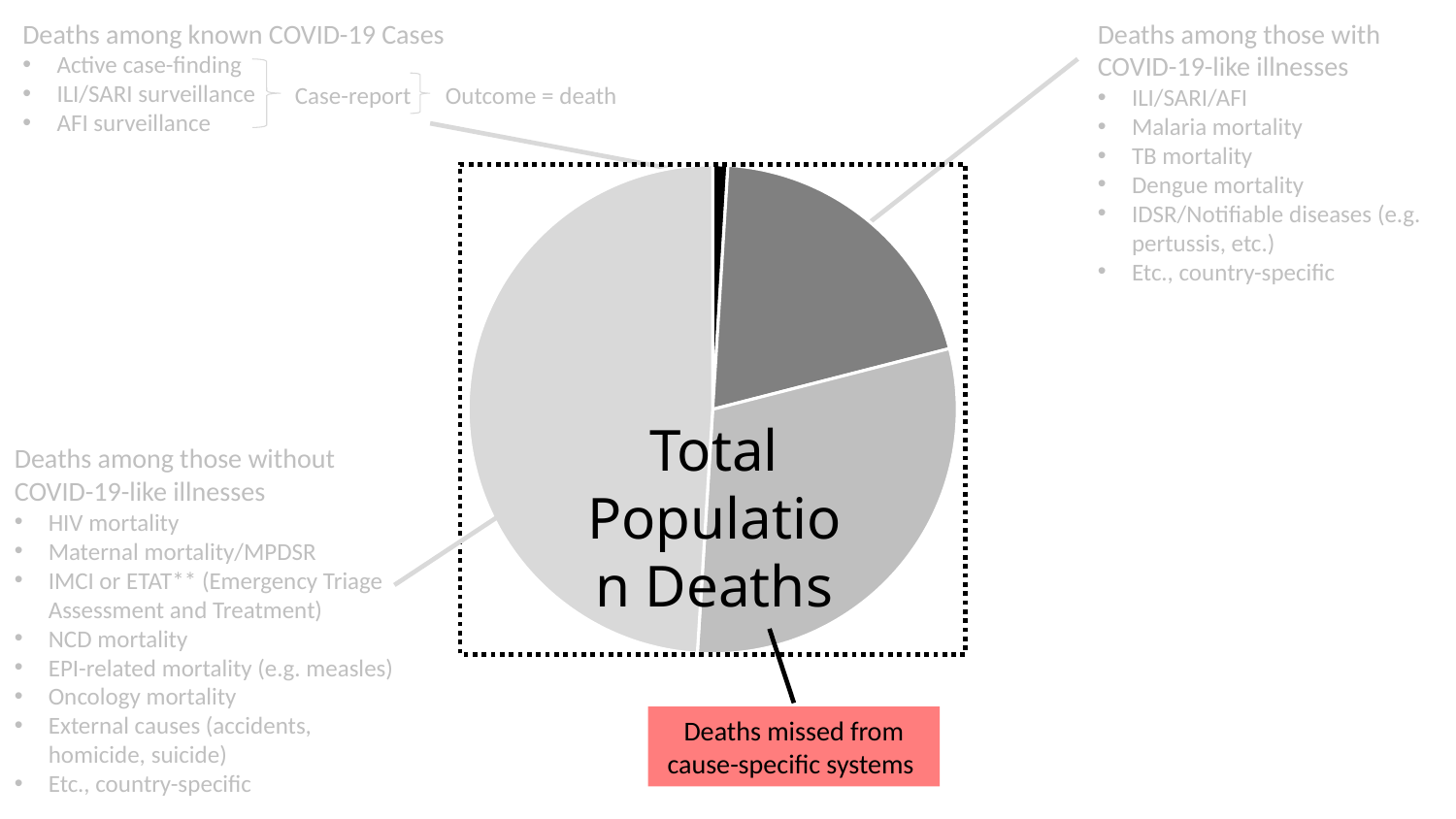
What colour is the slice labelled Deaths among known COVID-19 Cases? Black Which slice is larger: Deaths missed from cause-specific systems or Deaths among those with COVID-19-like illnesses? Deaths missed from cause-specific systems Which category has the smallest slice of the pie chart? Deaths among known COVID-19 Cases Which slice is larger: Deaths missed from cause-specific systems or Deaths among known COVID-19 Cases? Deaths missed from cause-specific systems What text is written in the centre of the pie chart? Total Population Deaths How many slices does the pie chart have? 4 What kind of chart is shown on the slide? Pie chart Which category has the largest slice of the pie chart? Deaths among those without COVID-19-like illnesses Which slice is larger: Deaths among those with COVID-19-like illnesses or Deaths among those without COVID-19-like illnesses? Deaths among those without COVID-19-like illnesses